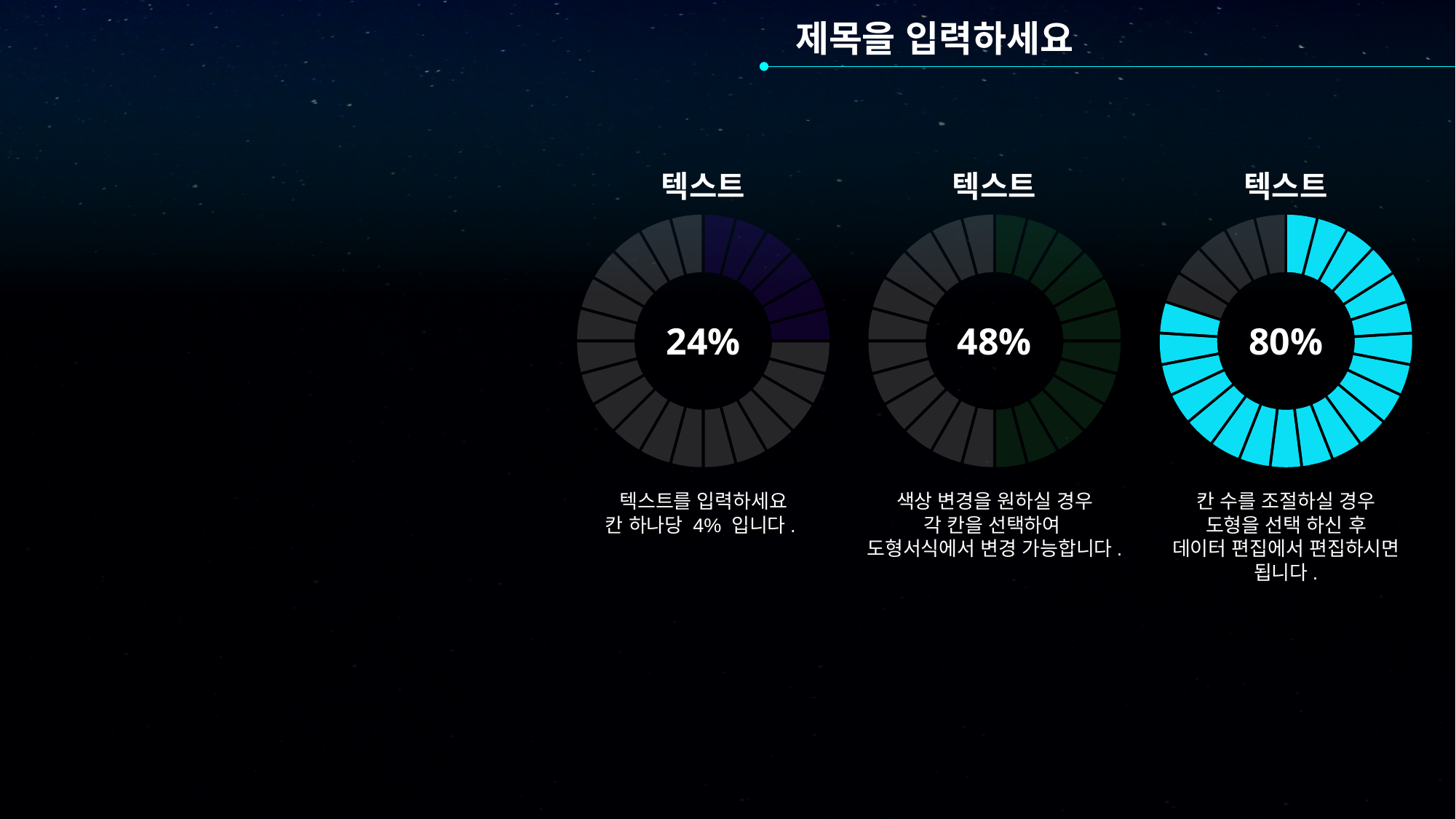
What is the difference between the percentage in the middle donut chart and the percentage in the left donut chart? 24% Is the percentage in the middle donut chart larger or smaller than the percentage in the right donut chart? Smaller What percentage is shown in the center of the right donut chart? 80% According to the text under the left donut chart, what percentage does each segment represent? 4% What percentage is shown in the center of the middle donut chart? 48% What is the difference between the percentage in the right donut chart and the percentage in the left donut chart? 56% What kind of chart is used on this slide? Donut chart How many donut charts are on the slide? 3 What colour are the highlighted segments in the right donut chart? Cyan What percentage is shown in the center of the left donut chart? 24% Which of the three donut charts shows the lowest percentage? The left chart (24%) Which of the three donut charts shows the highest percentage? The right chart (80%)